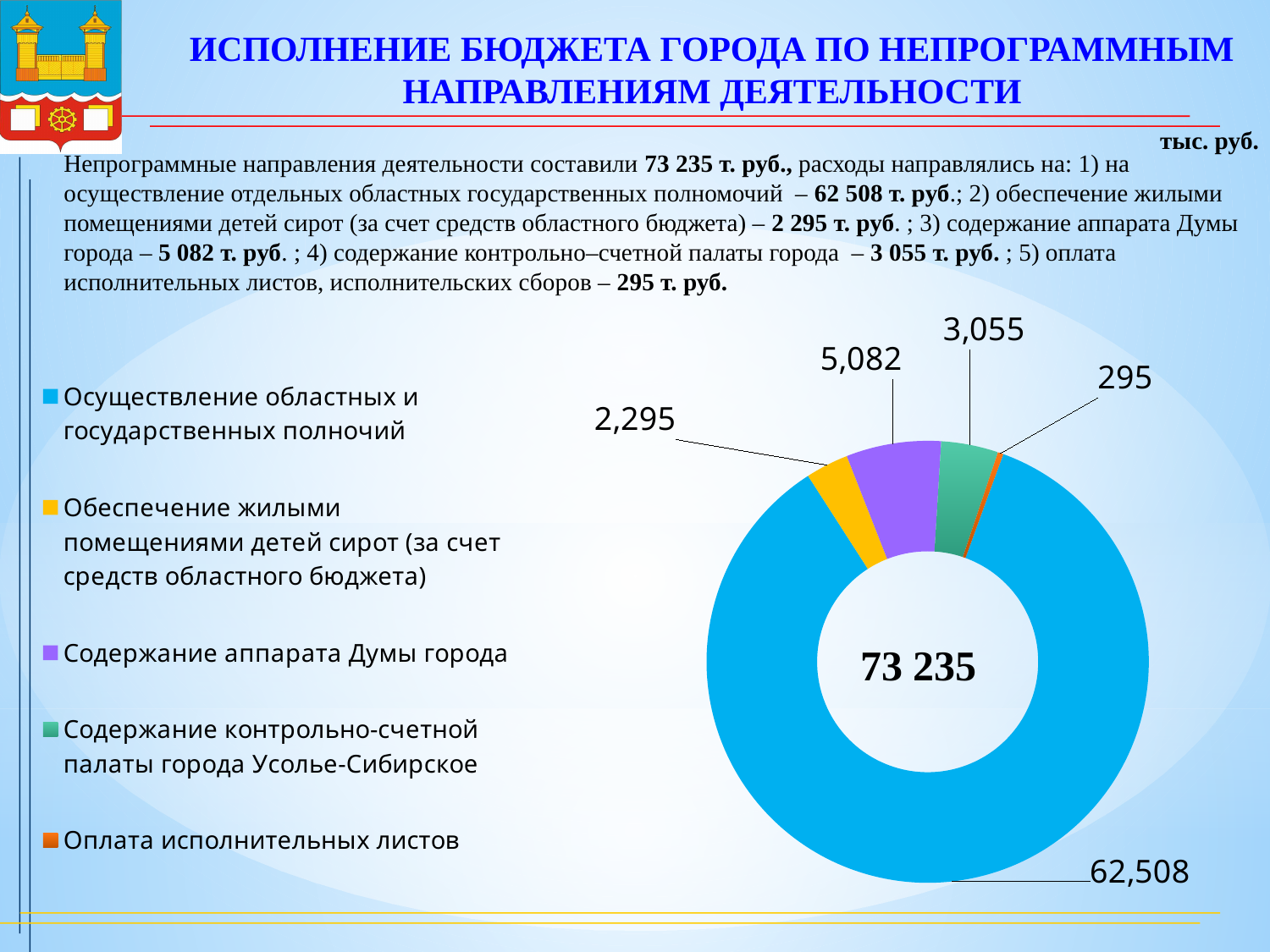
What value is shown for Оплата исполнительных листов? 295 What colour is the slice for Содержание аппарата Думы города? purple Which category has the smallest slice of the chart? Оплата исполнительных листов What value is shown for Обеспечение жилыми помещениями детей сирот (за счет средств областного бюджета)? 2,295 How many slices does the chart have? 5 What value is shown for Осуществление областных и государственных полномочий? 62,508 What total value is printed in the centre of the chart? 73 235 Which category has the largest slice of the chart? Осуществление областных и государственных полномочий What value is shown for Содержание аппарата Думы города? 5,082 What is the difference between the values for Содержание аппарата Думы города and Содержание контрольно-счетной палаты города Усолье-Сибирское? 2,027 What kind of chart is shown on the slide? doughnut chart Which is larger: the value for Содержание контрольно-счетной палаты города Усолье-Сибирское or the value for Обеспечение жилыми помещениями детей сирот? Содержание контрольно-счетной палаты города Усолье-Сибирское